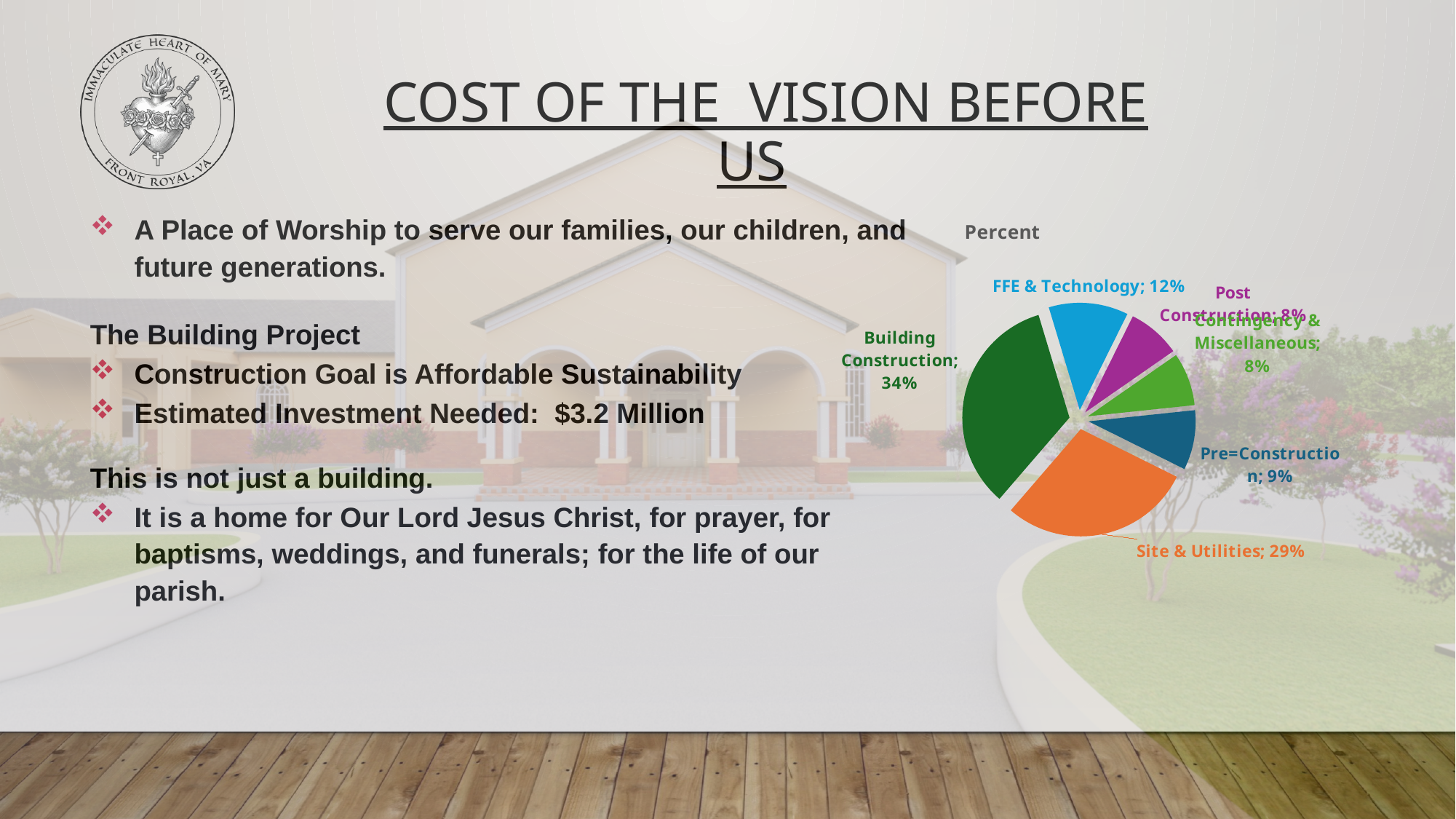
What is the combined share of Building Construction and Site & Utilities? 63% Which is larger, FFE & Technology or Pre=Construction? FFE & Technology What is the difference in percentage points between Building Construction and Site & Utilities? 5 Which category has the largest share of the pie? Building Construction What percentage does the FFE & Technology slice represent? 12% What percentage does the Pre=Construction slice represent? 9% What kind of chart is shown on the slide? pie chart What percentage does the Site & Utilities slice represent? 29% How many slices does the pie chart have? 6 What is the title of the chart? Percent What colour is the Site & Utilities slice? orange What percentage does the Building Construction slice represent? 34%